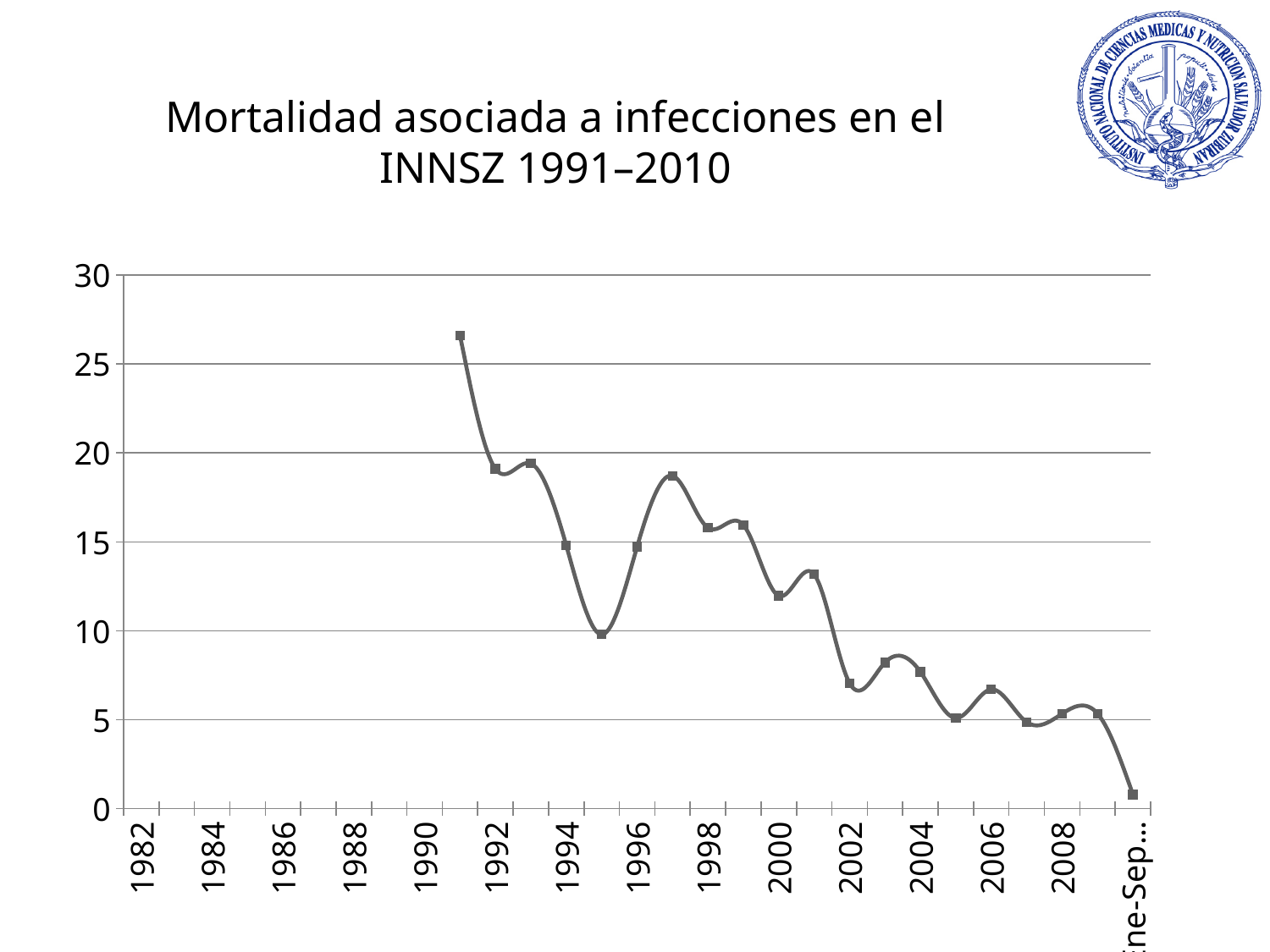
Which is larger, the value for 1991 or the value for 1992? 1991 What kind of chart is shown on the slide? line chart What is the title of the chart on the slide? Mortalidad asociada a infecciones en el INNSZ 1991–2010 Is the value for 1991 greater or less than 25? greater Which is larger, the value for 1995 or the value for 1997? 1997 Which year has the highest value on the chart? 1991 Is the value for 2002 greater or less than 10? less Is the value for 1997 greater or less than 15? greater Overall, do the values rise or fall from 1991 to the end of the series? fall Which is larger, the value for 2000 or the value for 2004? 2000